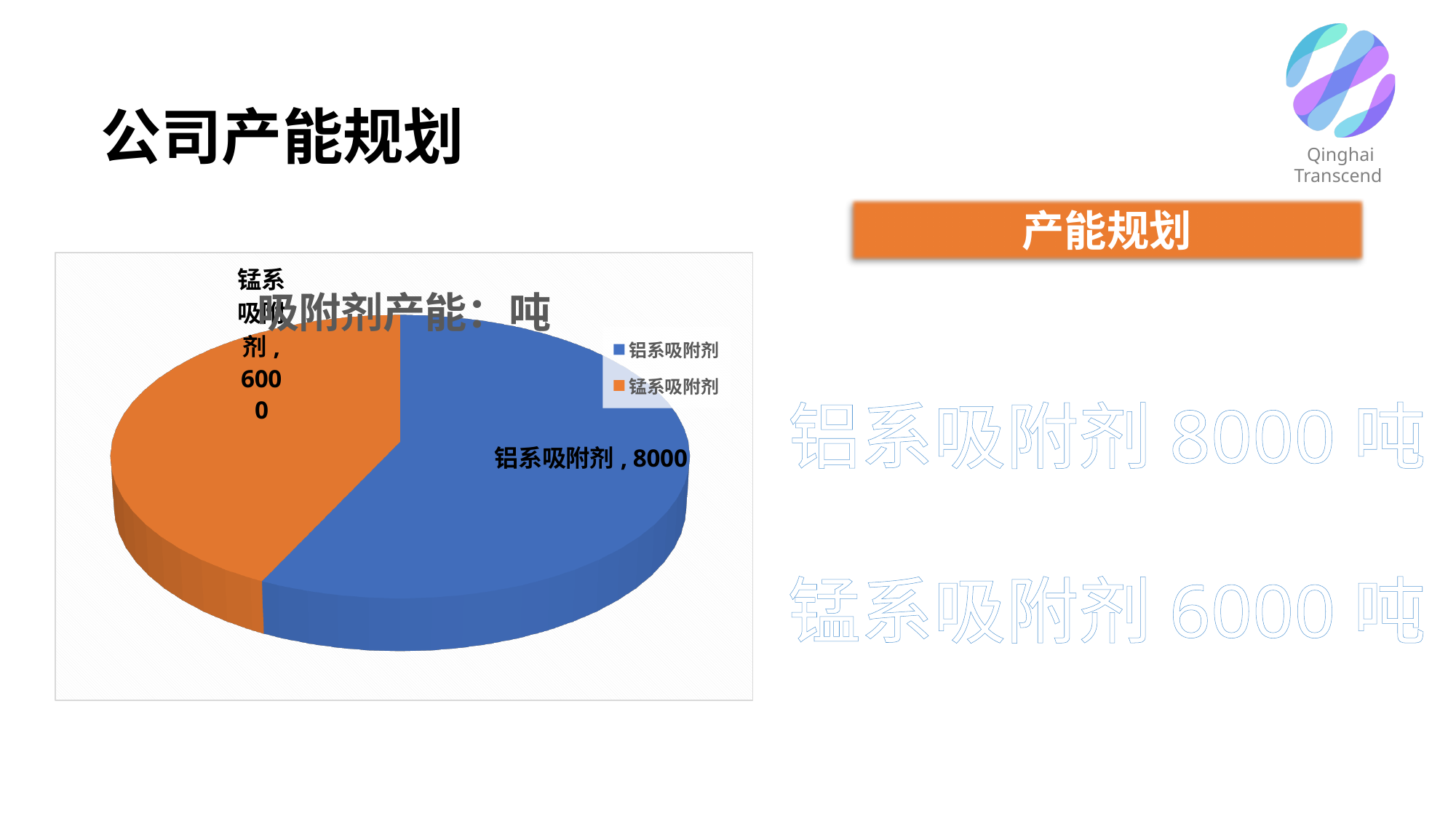
How many entries does the legend of the pie chart list? 2 What is the value for 铝系吸附剂 in the pie chart? 8000 What is the title of the pie chart? 吸附剂产能：吨 What kind of chart is shown on the slide? pie chart What is the value for 锰系吸附剂 in the pie chart? 6000 What is the difference between the values for 铝系吸附剂 and 锰系吸附剂? 2000 What colour is the 锰系吸附剂 slice in the pie chart? orange How many slices does the pie chart have? 2 What is the total of all slices in the pie chart? 14000 Which is larger, the value for 铝系吸附剂 or the value for 锰系吸附剂? 铝系吸附剂 Which category has the largest slice in the pie chart? 铝系吸附剂 Which category has the smallest slice in the pie chart? 锰系吸附剂